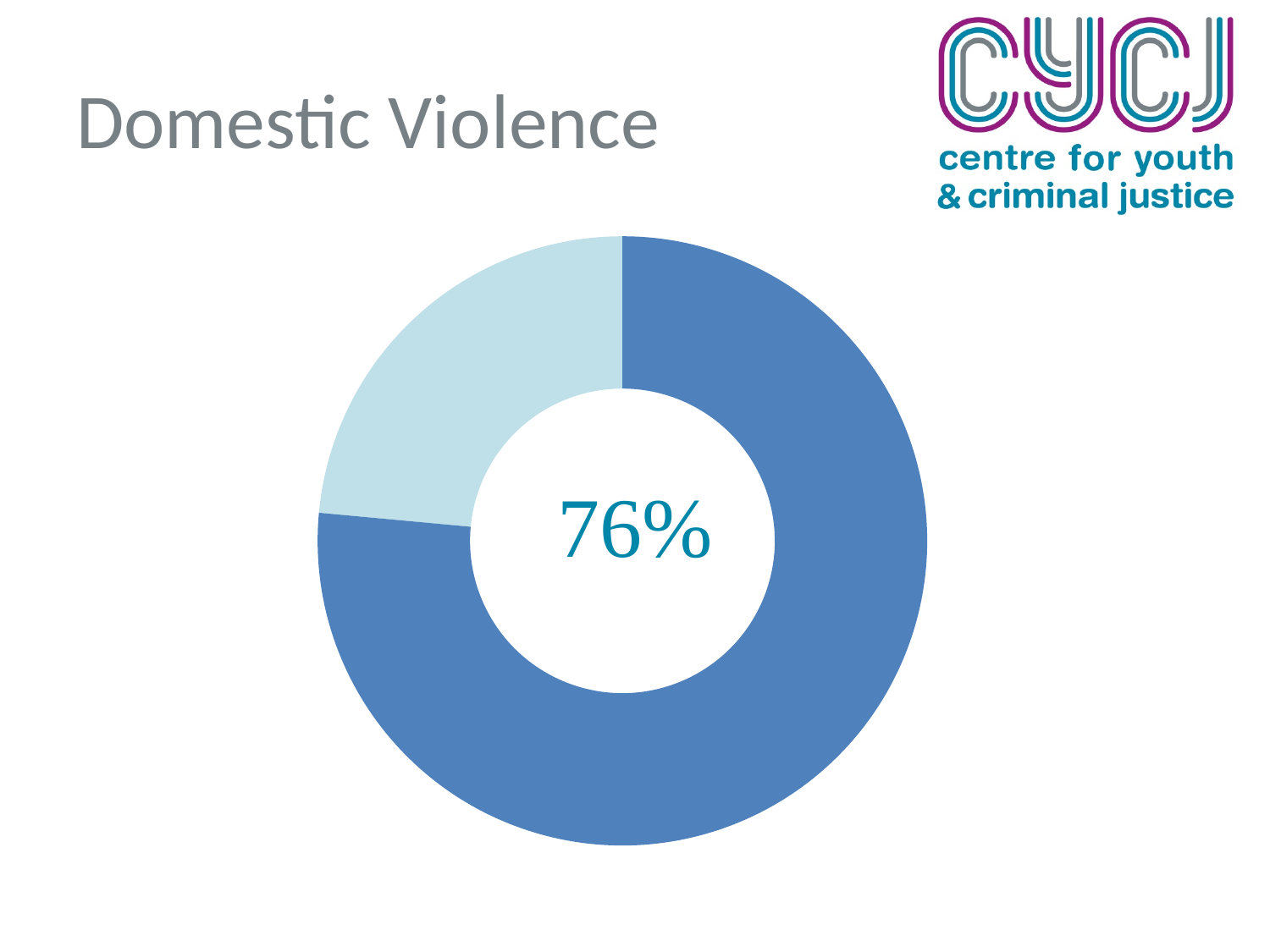
What share of the doughnut chart does the dark blue slice represent? 76% Is the share of the light blue slice greater or less than 50%? less Which slice of the doughnut chart is larger, the dark blue one or the light blue one? The dark blue one Which slice of the doughnut chart is the smallest? The light blue slice What is the title of the slide containing the doughnut chart? Domestic Violence What percentage is printed in the centre of the doughnut chart? 76% How many slices does the doughnut chart have? 2 Is the share of the dark blue slice greater or less than 50%? greater What colour is the larger slice of the doughnut chart? Dark blue What share of the doughnut chart does the light blue slice represent? 24% What kind of chart is shown on the slide? Doughnut (pie) chart